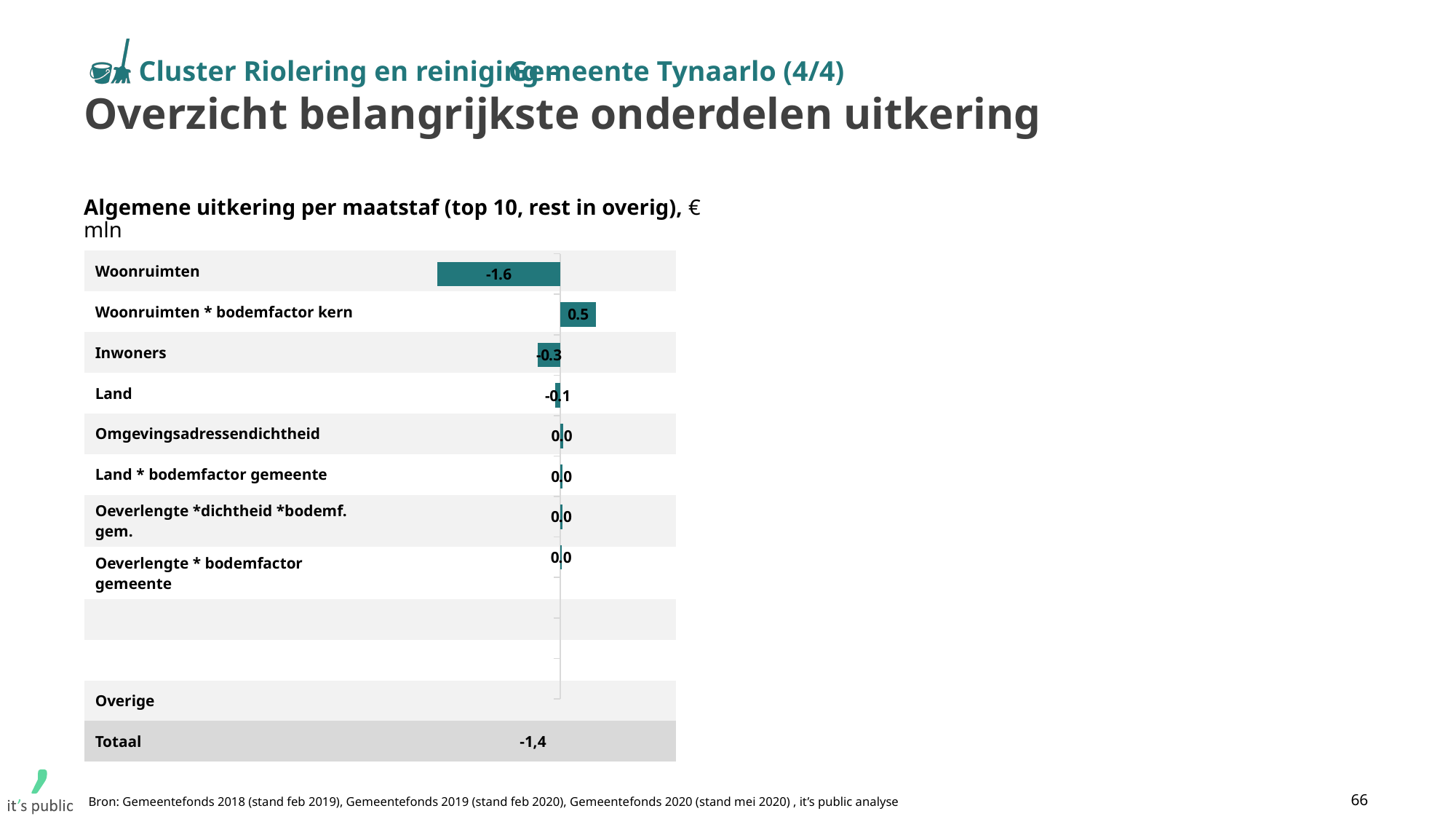
Which is larger, the value for Inwoners or the value for Land? Land What is the value for Inwoners? -0.3 How many categories with a plotted bar value are shown in the chart (excluding Overige and Totaal)? 8 Which category has the lowest (most negative) value? Woonruimten What is the value shown for Totaal? -1,4 What is the value for Woonruimten? -1.6 What is the difference between the values for Woonruimten * bodemfactor kern and Inwoners? 0.8 What is the value for Land? -0.1 What is the value for Woonruimten * bodemfactor kern? 0.5 Which category has the highest value? Woonruimten * bodemfactor kern What is the title of the chart? Algemene uitkering per maatstaf (top 10, rest in overig), € mln What kind of chart is shown on the slide? Bar chart